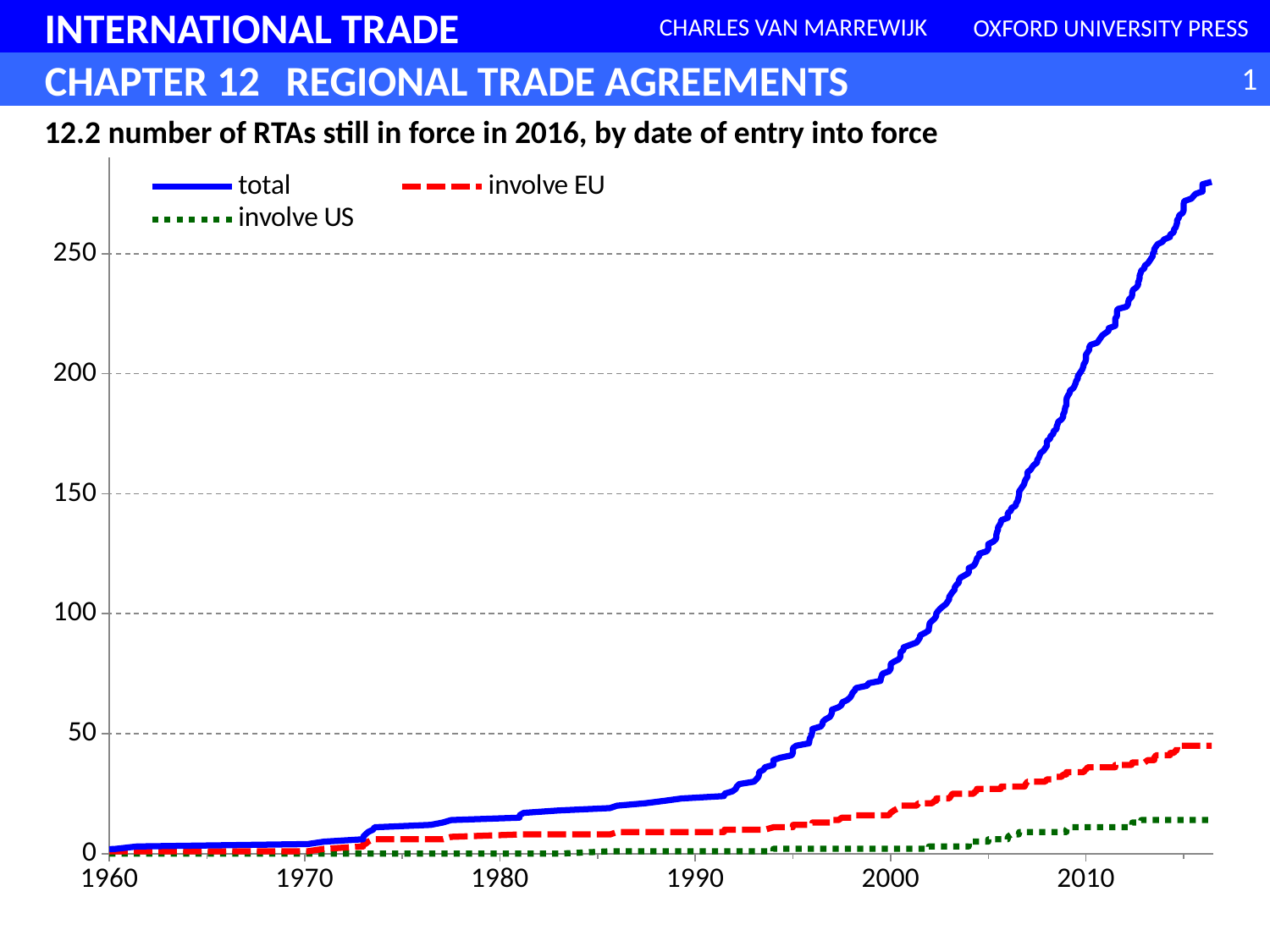
In 2010, which series has the larger value: involve EU or involve US? involve EU Is the value of the involve EU series in 2016 greater or less than 50? less What is the title of the chart? 12.2 number of RTAs still in force in 2016, by date of entry into force Which series has the highest value in 2016? total Is the value of the total series in 2016 greater or less than 250? greater Does the total series rise or fall from 1960 to 2016? rise Is the value of the total series in 2000 greater or less than 50? greater Which series is drawn as a solid blue line? total How many series does the legend list? 3 What kind of chart is shown on the slide? line chart